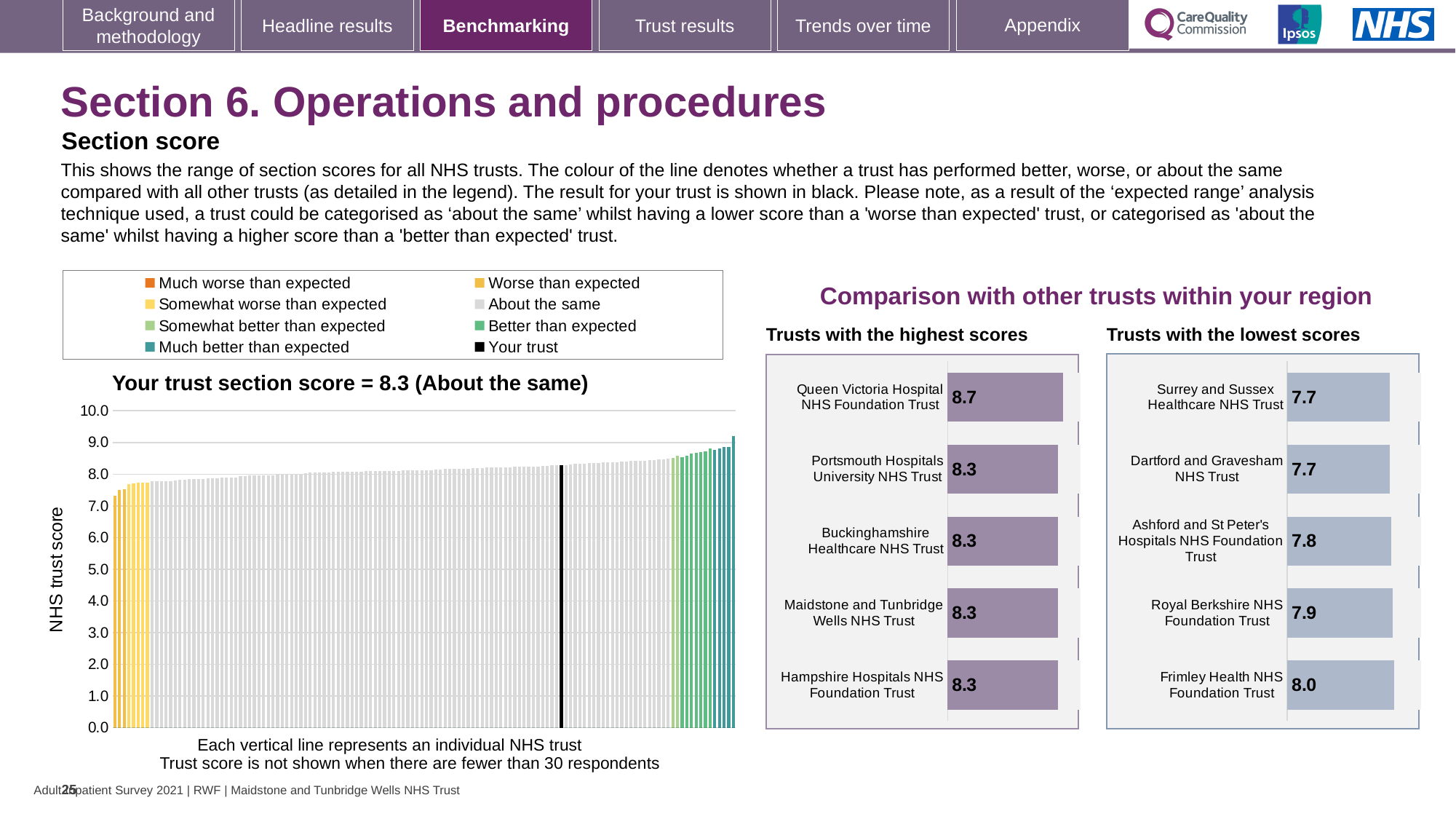
In the 'Trusts with the lowest scores' chart, what is the score for Frimley Health NHS Foundation Trust? 8.0 In the 'Trusts with the lowest scores' chart, which has the larger score: Ashford and St Peter's Hospitals NHS Foundation Trust or Royal Berkshire NHS Foundation Trust? Royal Berkshire NHS Foundation Trust What is the y-axis label of the main chart on the left? NHS trust score How many entries does the legend of the main chart on the left list? 8 In the 'Trusts with the highest scores' chart, what is the difference between the scores of Queen Victoria Hospital NHS Foundation Trust and Portsmouth Hospitals University NHS Trust? 0.4 In the 'Trusts with the lowest scores' chart, which trust has the highest score? Frimley Health NHS Foundation Trust How many trusts are shown in the 'Trusts with the highest scores' chart? 5 In the 'Trusts with the highest scores' chart, what is the score for Queen Victoria Hospital NHS Foundation Trust? 8.7 In the 'Trusts with the highest scores' chart, which trust has the highest score? Queen Victoria Hospital NHS Foundation Trust What kind of chart is the main chart on the left showing all NHS trusts? Bar chart In the 'Trusts with the lowest scores' chart, what is the difference between the scores of Frimley Health NHS Foundation Trust and Surrey and Sussex Healthcare NHS Trust? 0.3 In the main chart on the left, what is the section score for your trust? 8.3